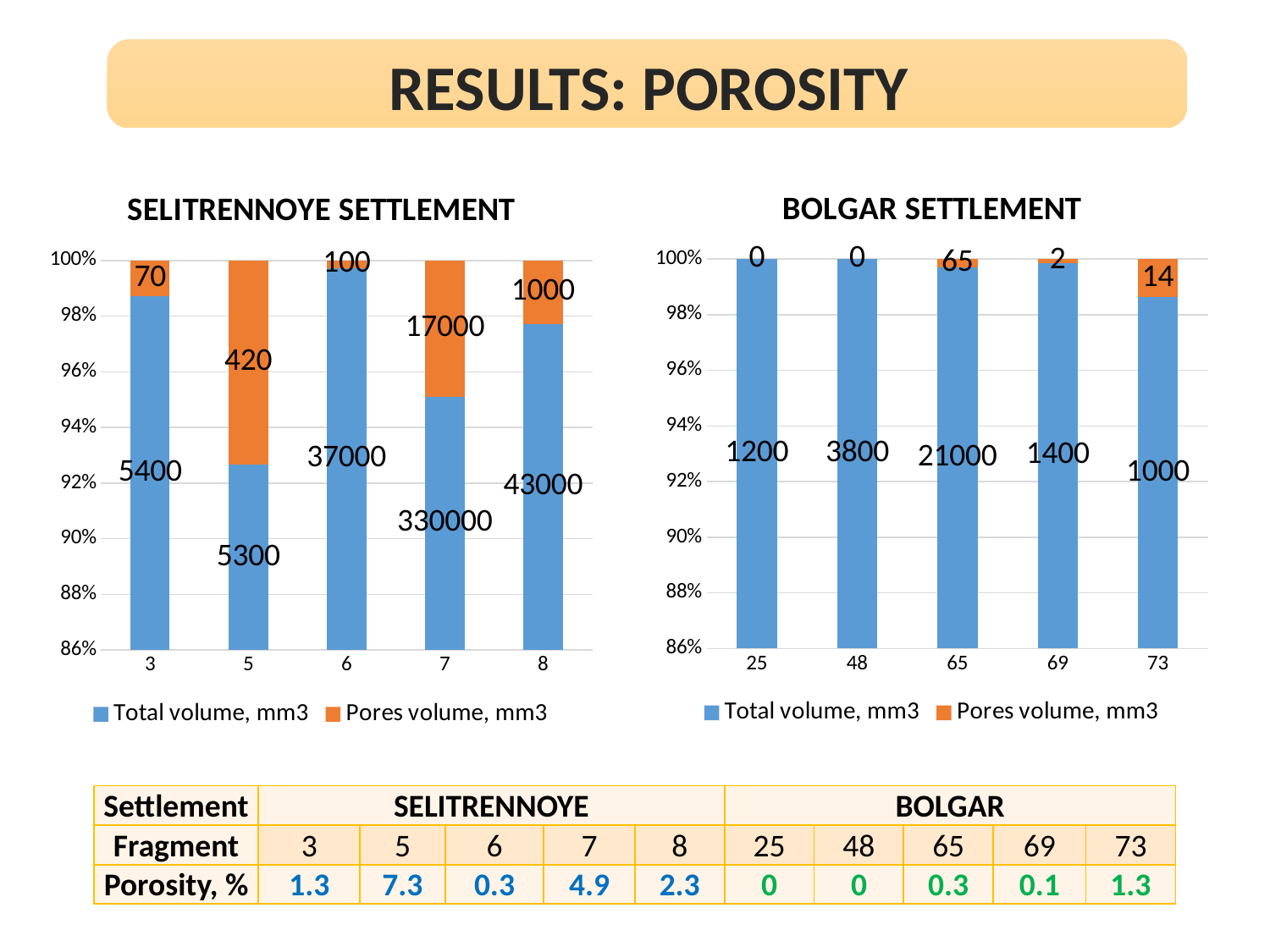
In the Selitrennoye Settlement chart, which fragment has the highest Pores volume, mm3? 7 In the Selitrennoye Settlement chart, what is the difference in Total volume, mm3 between fragment 8 and fragment 6? 6000 How many fragments are shown in the Bolgar Settlement chart? 5 In the Bolgar Settlement chart, what is the Pores volume, mm3 for fragment 73? 14 What type of chart is the Selitrennoye Settlement chart? Stacked bar chart In the Selitrennoye Settlement chart, what is the Total volume, mm3 for fragment 7? 330000 In the Bolgar Settlement chart, what is the Total volume, mm3 for fragment 48? 3800 In the Bolgar Settlement chart, which colour represents Pores volume, mm3? Orange How many series does the legend of the Selitrennoye Settlement chart list? 2 In the Bolgar Settlement chart, which has a larger Pores volume, mm3: fragment 65 or fragment 69? 65 In the Bolgar Settlement chart, which fragment has the lowest Total volume, mm3? 73 In the Selitrennoye Settlement chart, what is the Pores volume, mm3 for fragment 5? 420